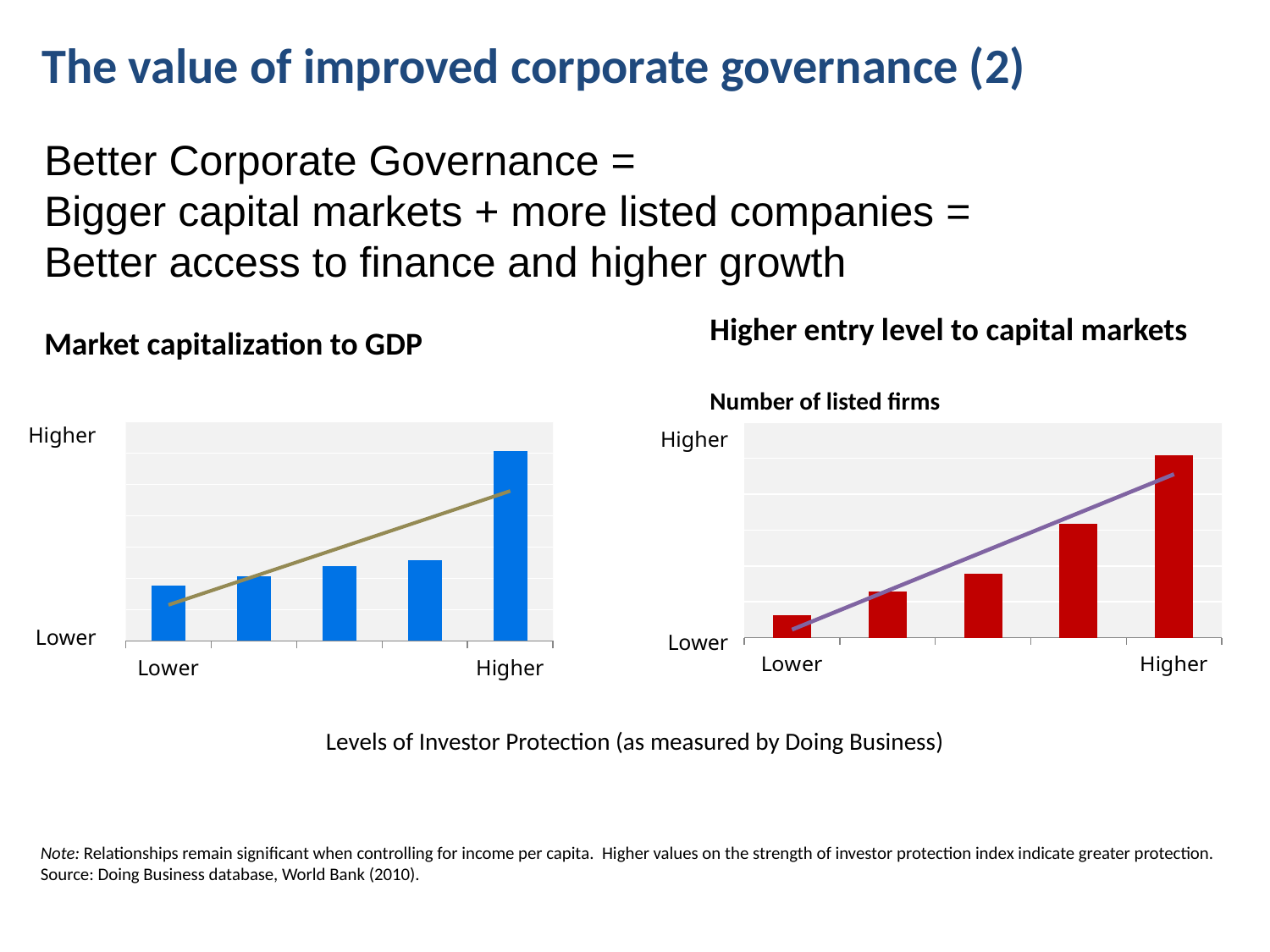
In the 'Number of listed firms' chart, which bar is taller: the one at 'Lower' or the one at 'Higher' investor protection? Higher How many bars are plotted in the 'Number of listed firms' chart? 5 In the 'Market capitalization to GDP' chart, which bar is taller: the one at 'Lower' or the one at 'Higher' investor protection? Higher What colour are the bars in the 'Number of listed firms' chart? red What kind of chart is the 'Number of listed firms' chart? bar chart What is the x-axis label shared by both charts? Levels of Investor Protection (as measured by Doing Business) How many bars are plotted in the 'Market capitalization to GDP' chart? 5 In the 'Market capitalization to GDP' chart, which x-axis category has the tallest bar? Higher In the 'Market capitalization to GDP' chart, do the bars rise or fall as investor protection moves from Lower to Higher? rise What kind of chart is the 'Market capitalization to GDP' chart? bar chart In the 'Number of listed firms' chart, do the bars rise or fall as investor protection moves from Lower to Higher? rise In the 'Number of listed firms' chart, which x-axis category has the shortest bar? Lower